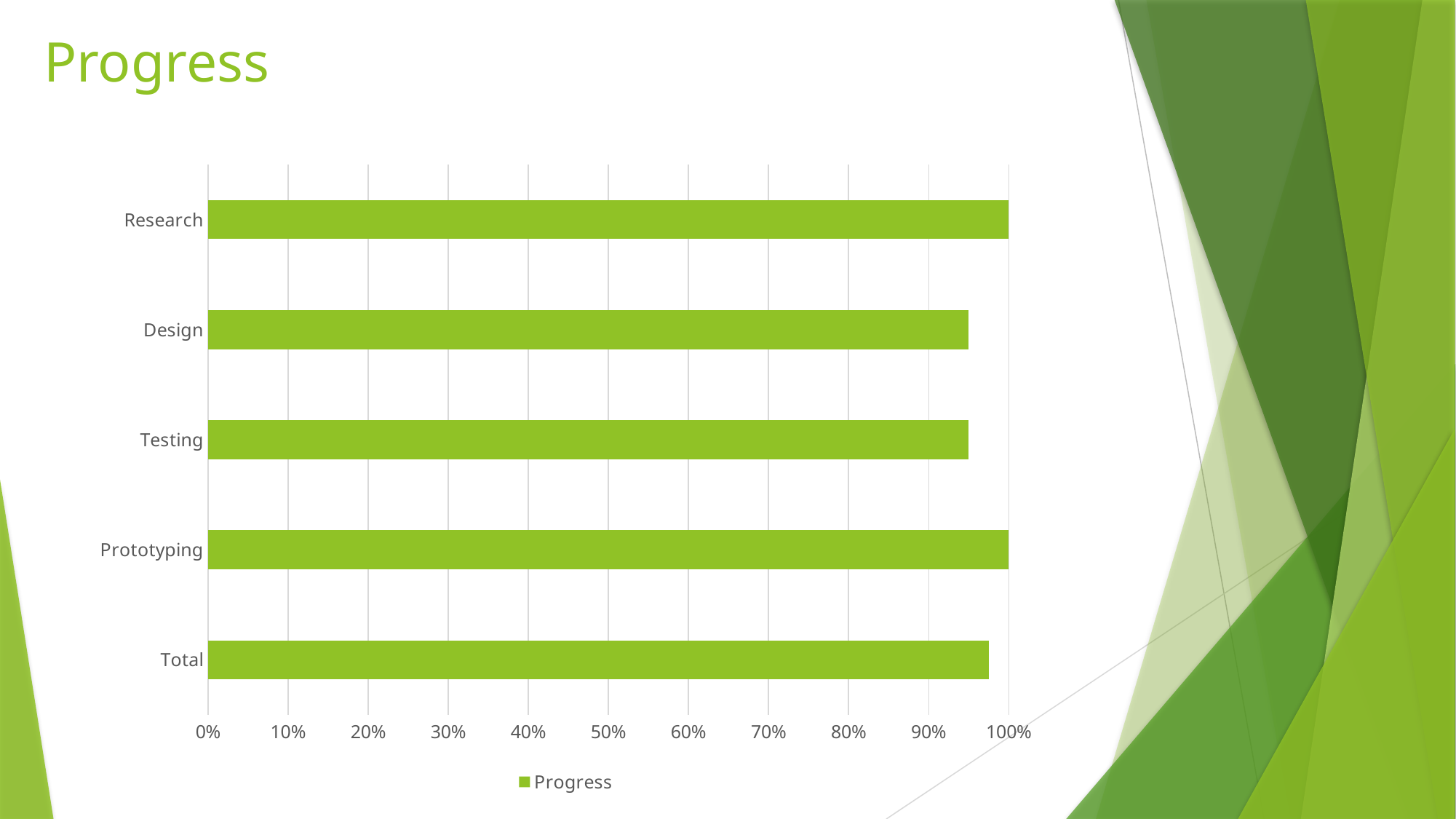
How many categories are plotted on the chart? 5 What is the value for Research? 100% How many series does the legend list? 1 What is the title of the slide? Progress Is the value for Design greater or less than 90%? greater Which is larger, the value for Research or the value for Design? Research What is the value for Prototyping? 100% What kind of chart is shown on the slide? bar chart Is the value for Total greater or less than 90%? greater Is the value for Testing greater or less than 100%? less What is the name of the series shown in the legend? Progress Which is larger, the value for Testing or the value for Prototyping? Prototyping